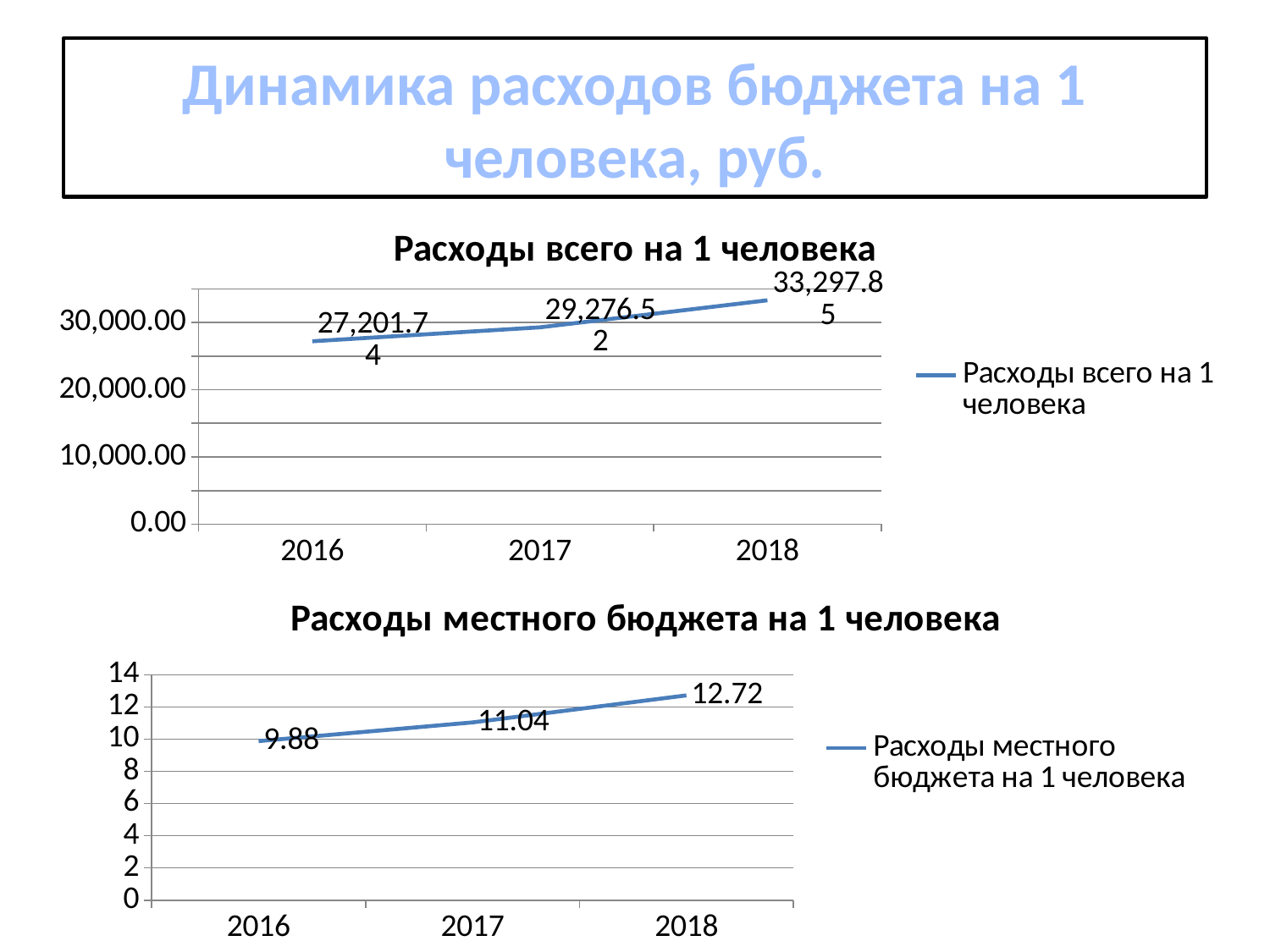
In the chart 'Расходы всего на 1 человека', what is the value for 2016? 27,201.74 How many series does the legend of the chart 'Расходы всего на 1 человека' list? 1 How many years are plotted in the chart 'Расходы местного бюджета на 1 человека'? 3 In the chart 'Расходы всего на 1 человека', which year has the highest value? 2018 In the chart 'Расходы местного бюджета на 1 человека', which year has the lowest value? 2016 In the chart 'Расходы всего на 1 человека', what is the difference between the 2018 and 2017 values? 4,021.33 In the chart 'Расходы местного бюджета на 1 человека', is the value for 2018 greater or less than 12? greater In the chart 'Расходы всего на 1 человека', do the values rise or fall from 2016 to 2018? rise What kind of chart is 'Расходы всего на 1 человека'? line chart In the chart 'Расходы местного бюджета на 1 человека', what is the value for 2017? 11.04 In the chart 'Расходы местного бюджета на 1 человека', what is the difference between the 2018 and 2016 values? 2.84 In the chart 'Расходы всего на 1 человека', what is the value for 2018? 33,297.85